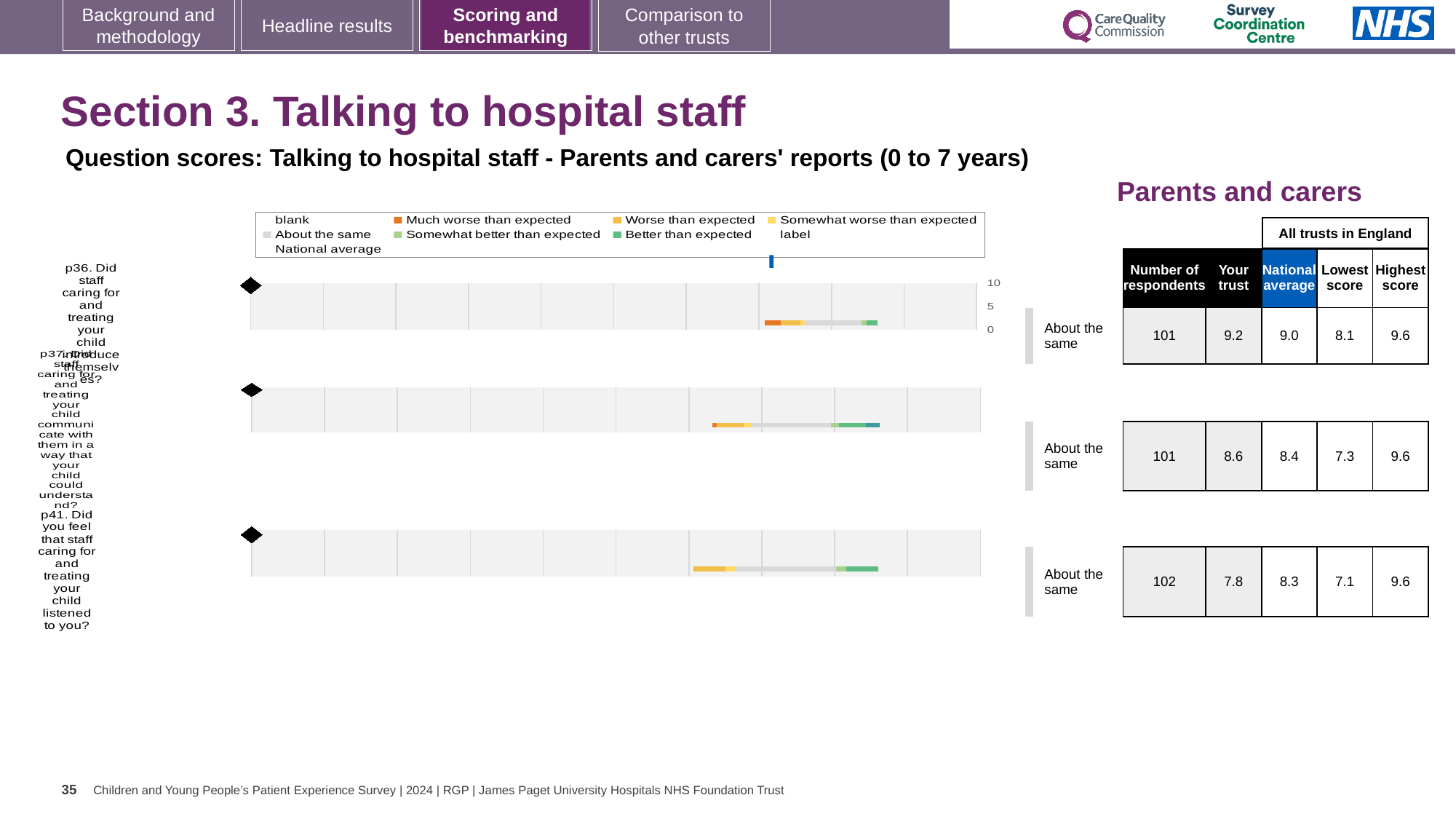
What benchmark category label is shown beside the p37 chart? About the same In the table next to the p37 chart, what is the National average score? 8.4 In the table next to the p41 chart, how many respondents are listed? 102 What is the highest tick value shown on the axis of the p36 chart? 10 In the table next to the p41 chart, what is the Lowest score? 7.1 For p36, what is the difference between the Highest score and the Lowest score in the table? 1.5 In the table next to the p36 chart, what is the 'Your trust' score? 9.2 How many question charts are shown on the slide? 3 For p41, is the 'Your trust' score higher or lower than the National average? lower Which question has the highest 'Your trust' score in the table? p36 What kind of chart is used to show the p36 question score? bar chart Which question has the lowest National average score in the table? p41